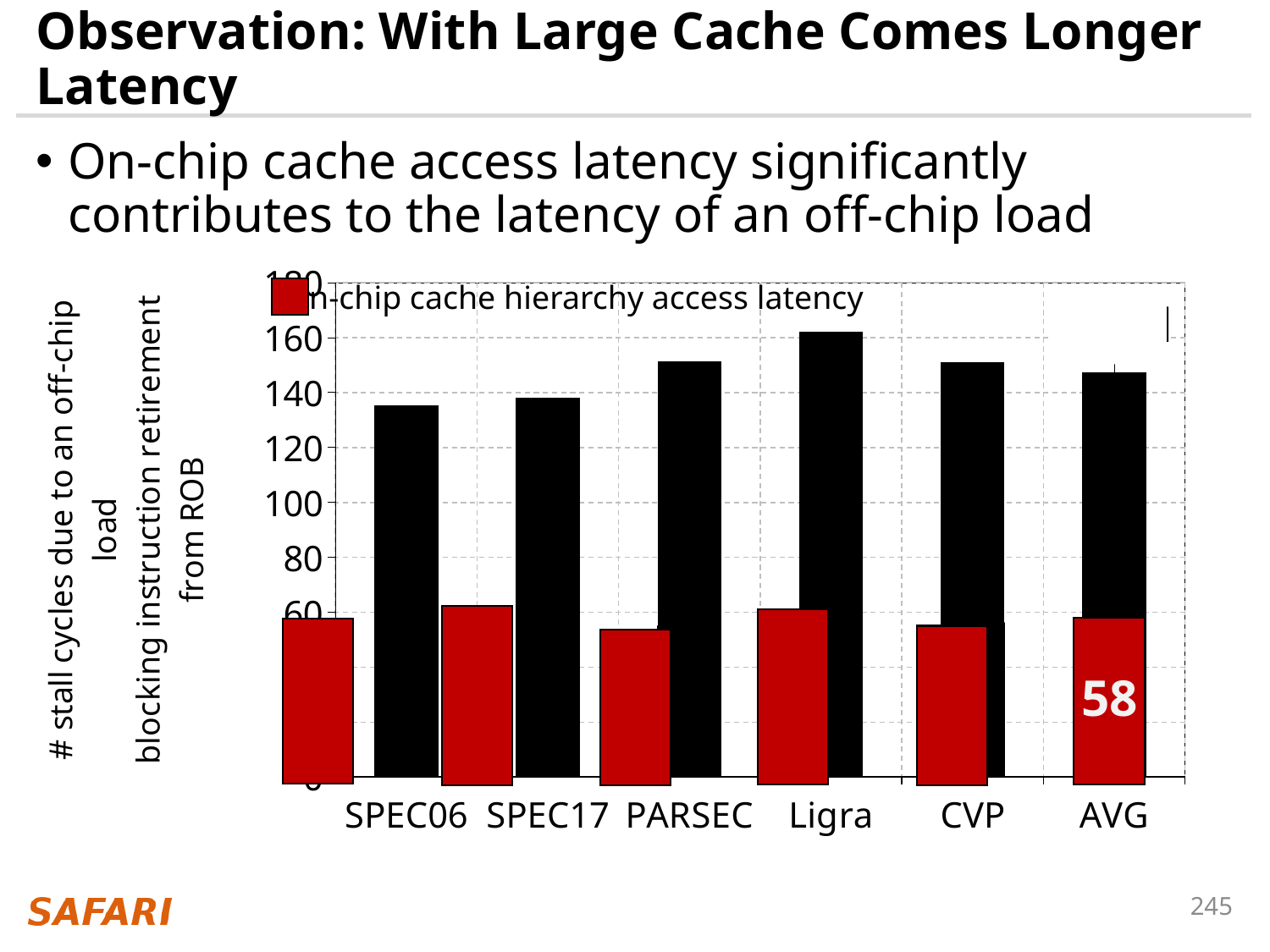
What kind of chart is shown on the slide? bar chart Is the red bar for PARSEC greater or less than 60? less Is the black bar for Ligra greater or less than 100? greater Is the black bar for SPEC06 greater or less than 140? less What is the label of the last category on the x axis? AVG Which is larger, the red bar for SPEC17 or the red bar for PARSEC? SPEC17 How many categories are shown on the x axis of the chart? 6 What value is labelled on the red bar for AVG? 58 Which category has the tallest black bar? Ligra What colour are the bars for on-chip cache hierarchy access latency? red Which is larger, the black bar for Ligra or the black bar for SPEC06? Ligra